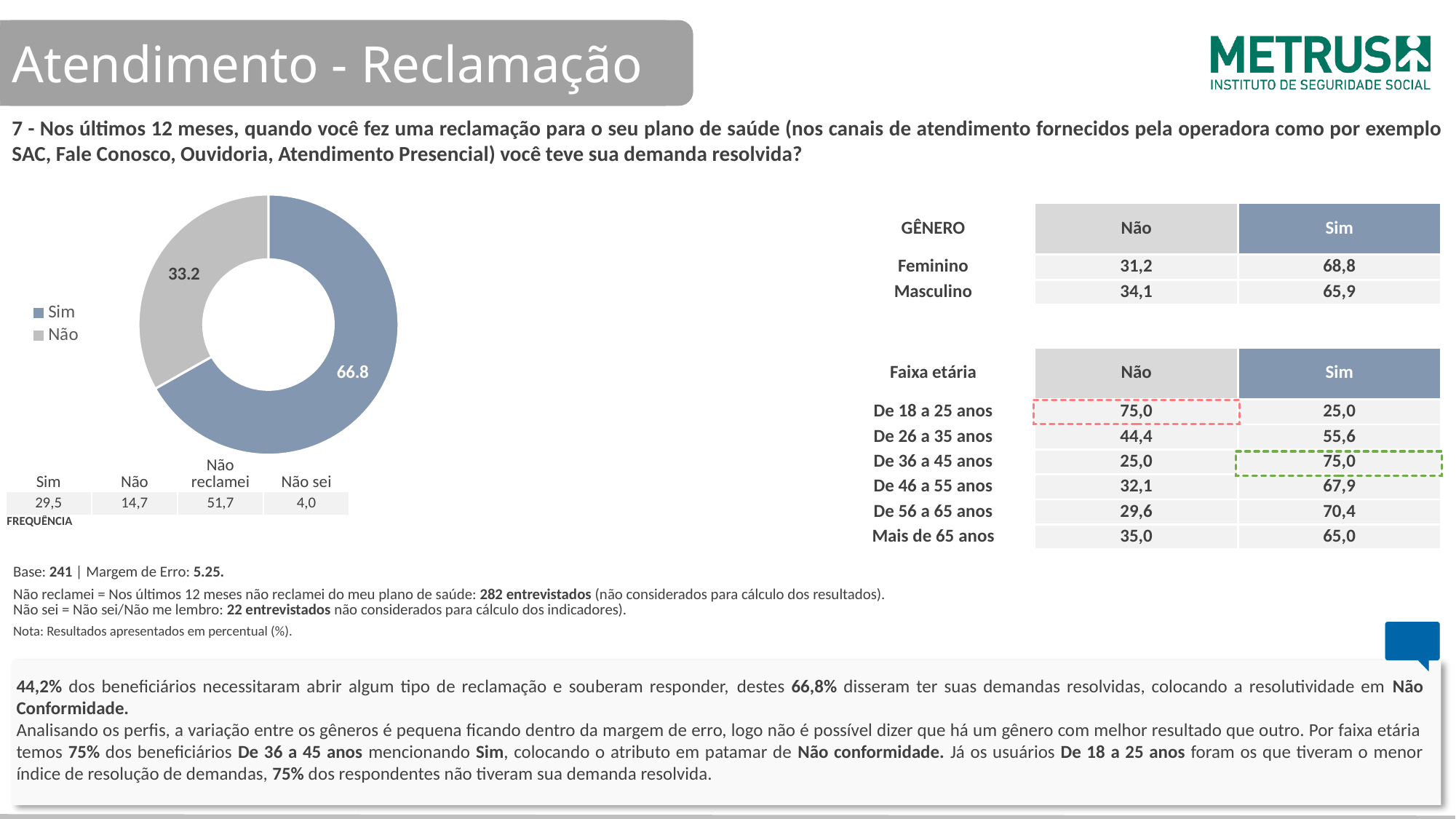
What colour is the Sim slice in the donut chart? Blue What is the value for Sim in the donut chart? 66.8 What kind of chart is shown on the slide? Donut (pie) chart What is the difference between the Sim and Não values in the donut chart? 33.6 How many entries does the legend of the donut chart list? 2 Which is larger in the donut chart, Sim or Não? Sim What is the value for Não in the donut chart? 33.2 Which category has the largest slice in the donut chart? Sim Is the value for Sim in the donut chart greater or less than 50? greater What colour is the Não slice in the donut chart? Grey How many categories does the donut chart show? 2 Which category has the smallest slice in the donut chart? Não